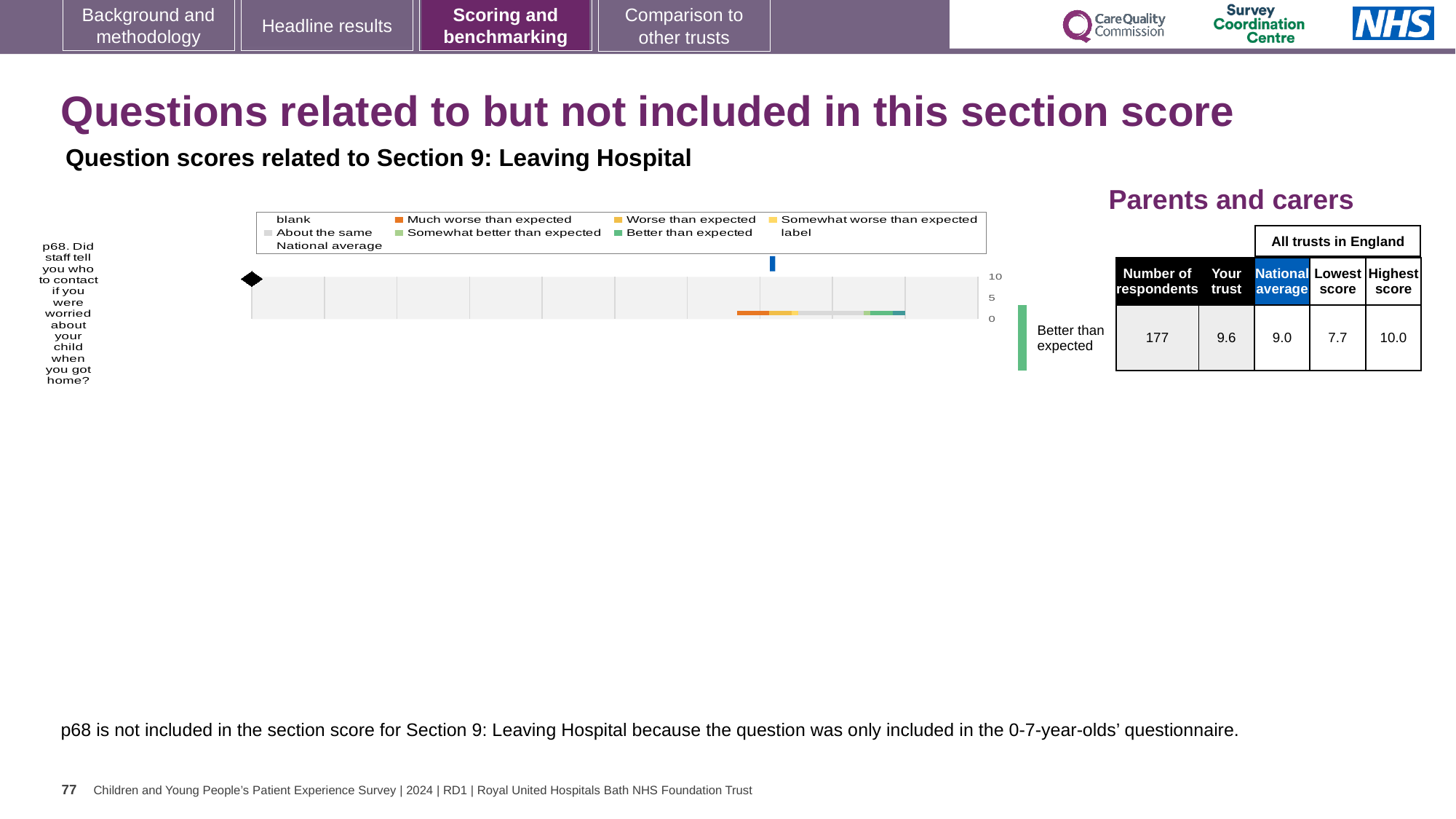
What is the highest score among all trusts in England for question p68? 10.0 What is the 'Your trust' score for question p68? 9.6 How many respondents answered question p68? 177 What type of chart is used to show the p68 question score? bar chart For question p68, which is higher: the trust's score or the national average? Your trust What is the difference between the highest and lowest trust scores for question p68? 2.3 By how much does the trust's score for p68 exceed the national average? 0.6 What is the national average score for question p68? 9.0 How many questions are plotted in the chart for Section 9: Leaving Hospital? 1 What is the lowest score among all trusts in England for question p68? 7.7 Is the trust's score for p68 greater or less than 5 on the chart's axis? greater What benchmark category label is shown next to the p68 bar? Better than expected